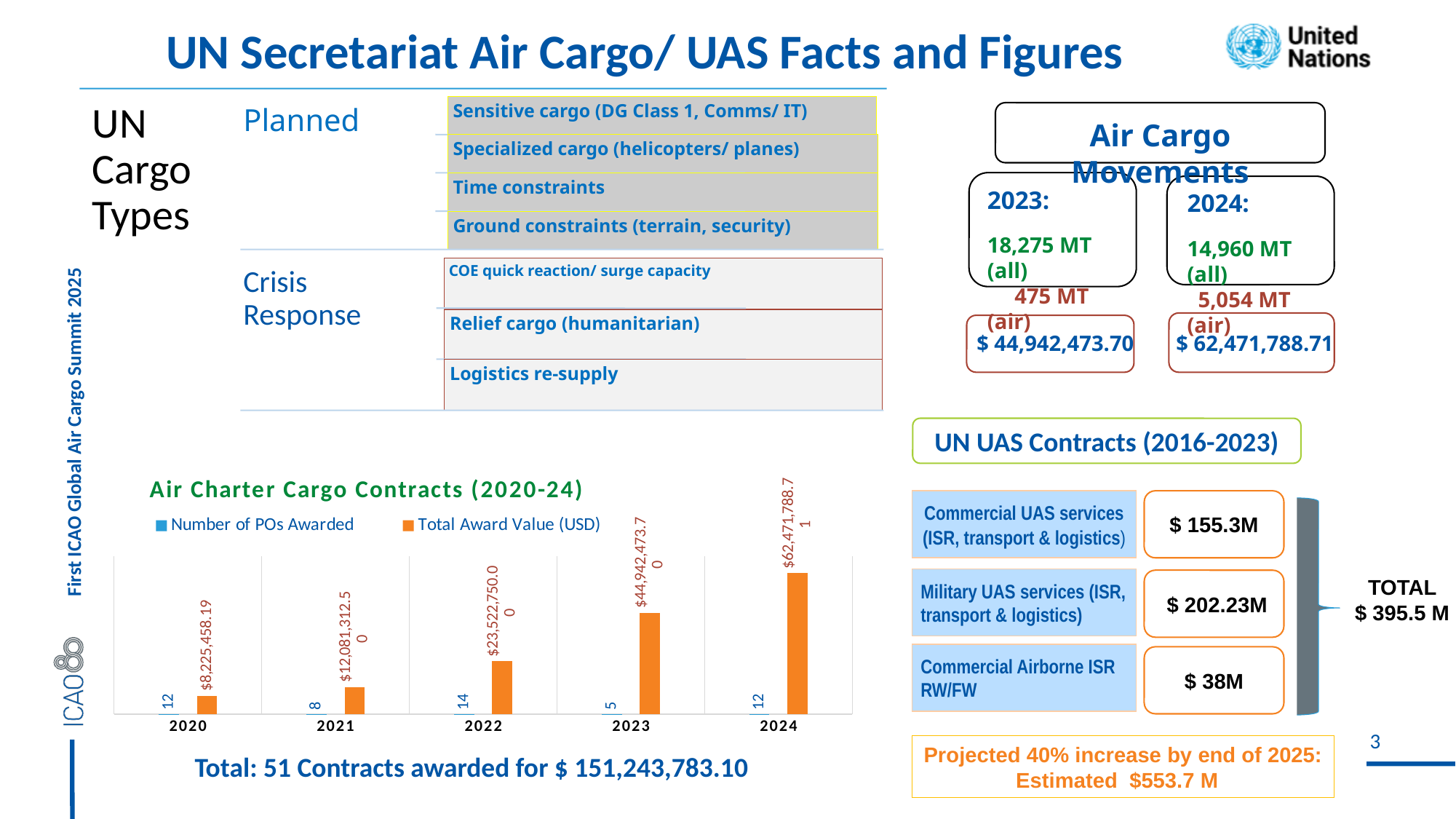
In the 'Air Charter Cargo Contracts (2020-24)' chart, what is the Number of POs Awarded in 2022? 14 In the 'Air Charter Cargo Contracts (2020-24)' chart, which year has the highest Total Award Value (USD)? 2024 In the 'Air Charter Cargo Contracts (2020-24)' chart, which year has the larger Total Award Value (USD), 2022 or 2023? 2023 In the 'Air Charter Cargo Contracts (2020-24)' chart, what is the Total Award Value (USD) for 2020? $8,225,458.19 In the 'Air Charter Cargo Contracts (2020-24)' chart, does the Total Award Value (USD) rise or fall from 2020 to 2024? rise In the 'Air Charter Cargo Contracts (2020-24)' chart, how many series does the legend list? 2 What kind of chart is the 'Air Charter Cargo Contracts (2020-24)' chart? bar chart In the 'Air Charter Cargo Contracts (2020-24)' chart, how many years are shown on the x axis? 5 In the 'Air Charter Cargo Contracts (2020-24)' chart, which year has the lowest Number of POs Awarded? 2023 In the 'Air Charter Cargo Contracts (2020-24)' chart, what is the Total Award Value (USD) for 2024? $62,471,788.71 In the 'Air Charter Cargo Contracts (2020-24)' chart, what is the difference in Number of POs Awarded between 2022 and 2021? 6 In the 'Air Charter Cargo Contracts (2020-24)' chart, what colour are the Total Award Value (USD) bars? orange